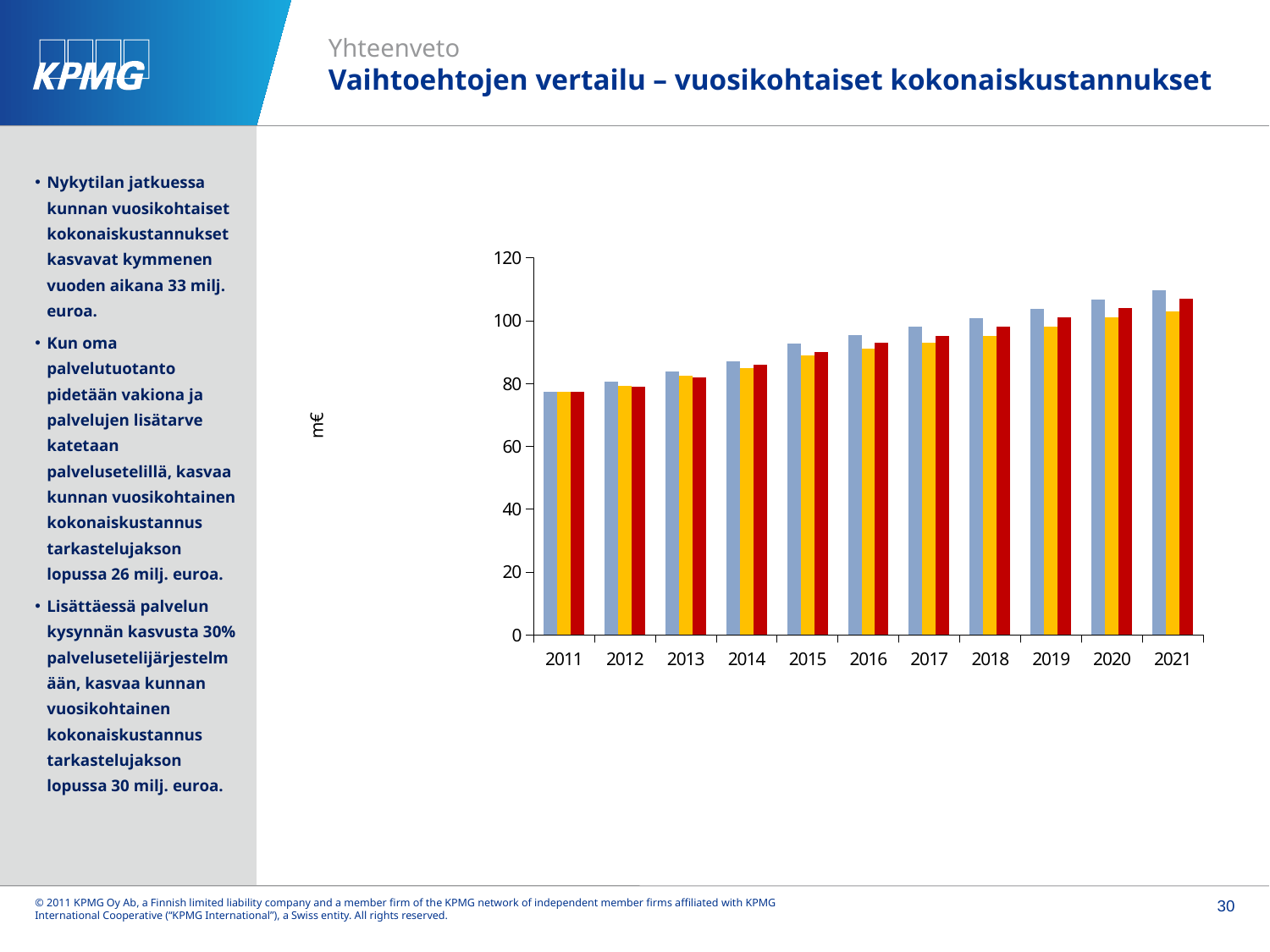
Is the value of the red bar for 2016 greater or less than 80? greater Is the value of the blue bar for 2021 greater or less than 100? greater Is the value of the yellow bar for 2015 greater or less than 100? less In 2021, which is larger: the blue bar or the yellow bar? the blue bar How many years are shown on the x axis of the chart? 11 Which year has the highest bars in the chart? 2021 Which year has the lowest bars in the chart? 2011 How many bars are plotted for each year in the chart? 3 Do the values in the chart rise or fall from 2011 to 2021? rise What kind of chart is shown on the slide? bar chart What is the label on the vertical axis of the chart? m€